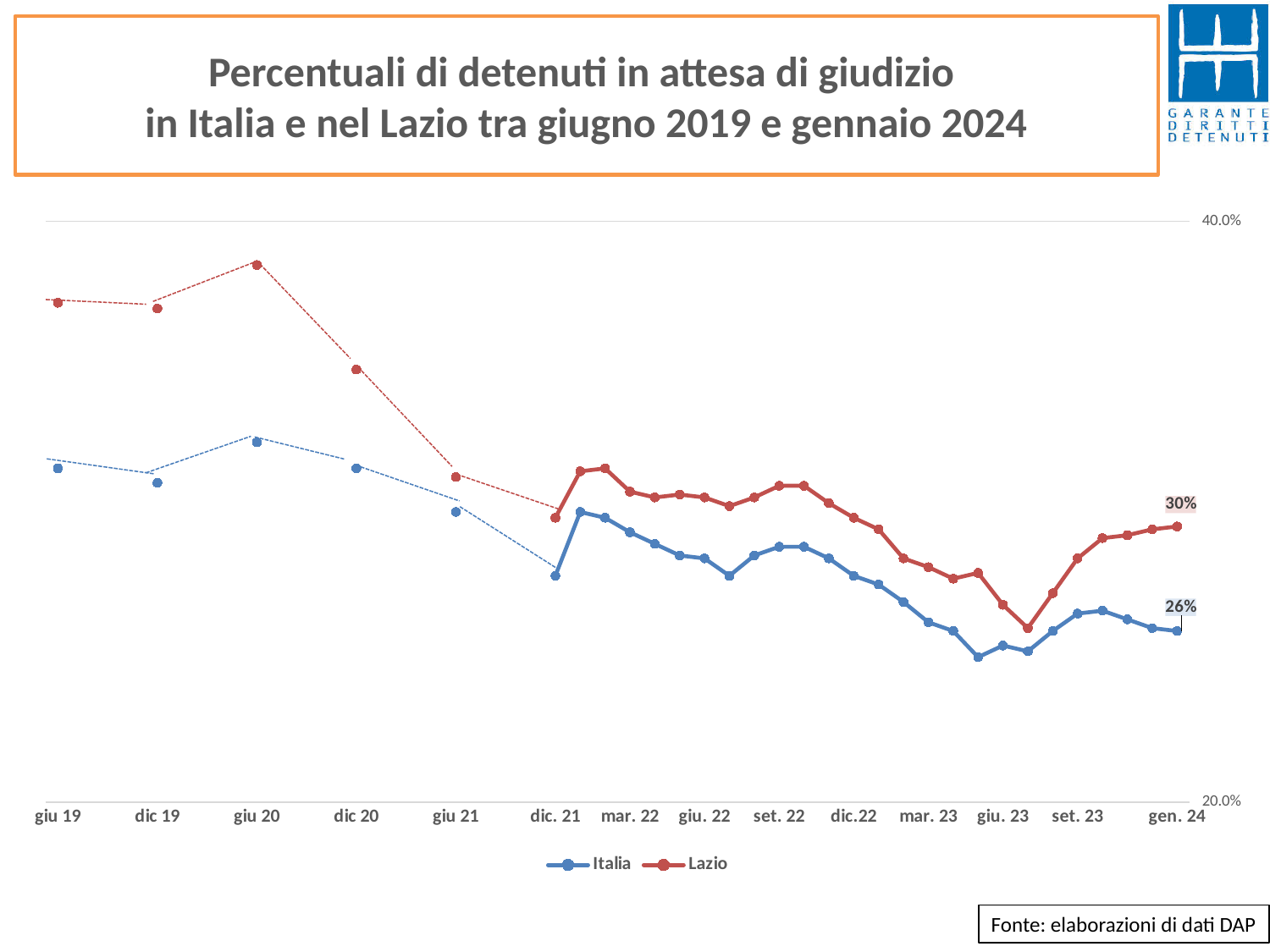
What is the difference between the Lazio and Italia values at gen. 24? 4 percentage points At which x-axis label does the Lazio series reach its highest value? giu 20 Is the value for Lazio at giu 20 greater or less than 40.0%? less Does the Italia series overall rise or fall from giu 19 to gen. 24? fall What is the highest value shown on the y axis? 40.0% How many series does the legend list? 2 What is the value for Lazio at gen. 24? 30% Which series is drawn in red? Lazio What kind of chart is shown on the slide? line chart How many labels are shown on the x axis? 14 At gen. 24, which series has the larger value, Italia or Lazio? Lazio What is the value for Italia at gen. 24? 26%